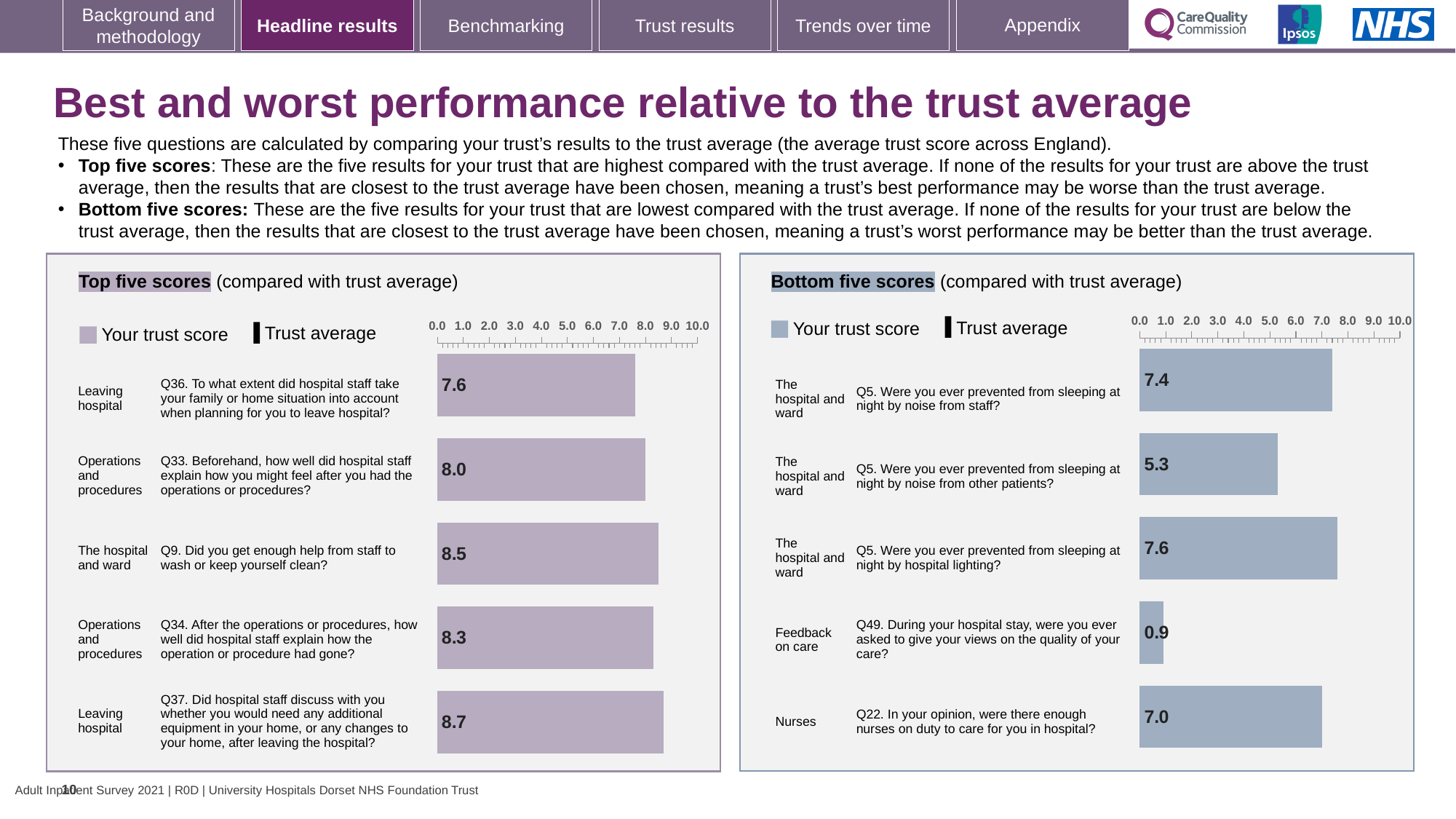
In the Bottom five scores chart, which question has the highest trust score? Q5. Were you ever prevented from sleeping at night by hospital lighting? In the Top five scores chart, what is the difference between the scores for Q37 and Q36? 1.1 In the Bottom five scores chart, what is the difference between the scores for Q5 about hospital lighting and Q5 about noise from other patients? 2.3 In the Bottom five scores chart, what is the trust score for Q22 about whether there were enough nurses on duty? 7.0 In the Bottom five scores chart, which has the larger score: Q5 about noise from staff or Q5 about noise from other patients? Q5 about noise from staff What kind of chart is used in the Top five scores panel? Bar chart In the Top five scores chart, which question has the lowest trust score? Q36. To what extent did hospital staff take your family or home situation into account when planning for you to leave hospital? In the Top five scores chart, what is the trust score for Q33 about how well staff explained how you might feel after operations or procedures? 8.0 In the Bottom five scores chart, what is the trust score for Q49 about being asked to give your views on the quality of your care? 0.9 In the Bottom five scores chart, which question has the lowest trust score? Q49. During your hospital stay, were you ever asked to give your views on the quality of your care? In the Top five scores chart, what is the trust score for Q9 (Did you get enough help from staff to wash or keep yourself clean?)? 8.5 In the Top five scores chart, which question has the highest trust score? Q37. Did hospital staff discuss with you whether you would need any additional equipment in your home, or any changes to your home, after leaving the hospital?